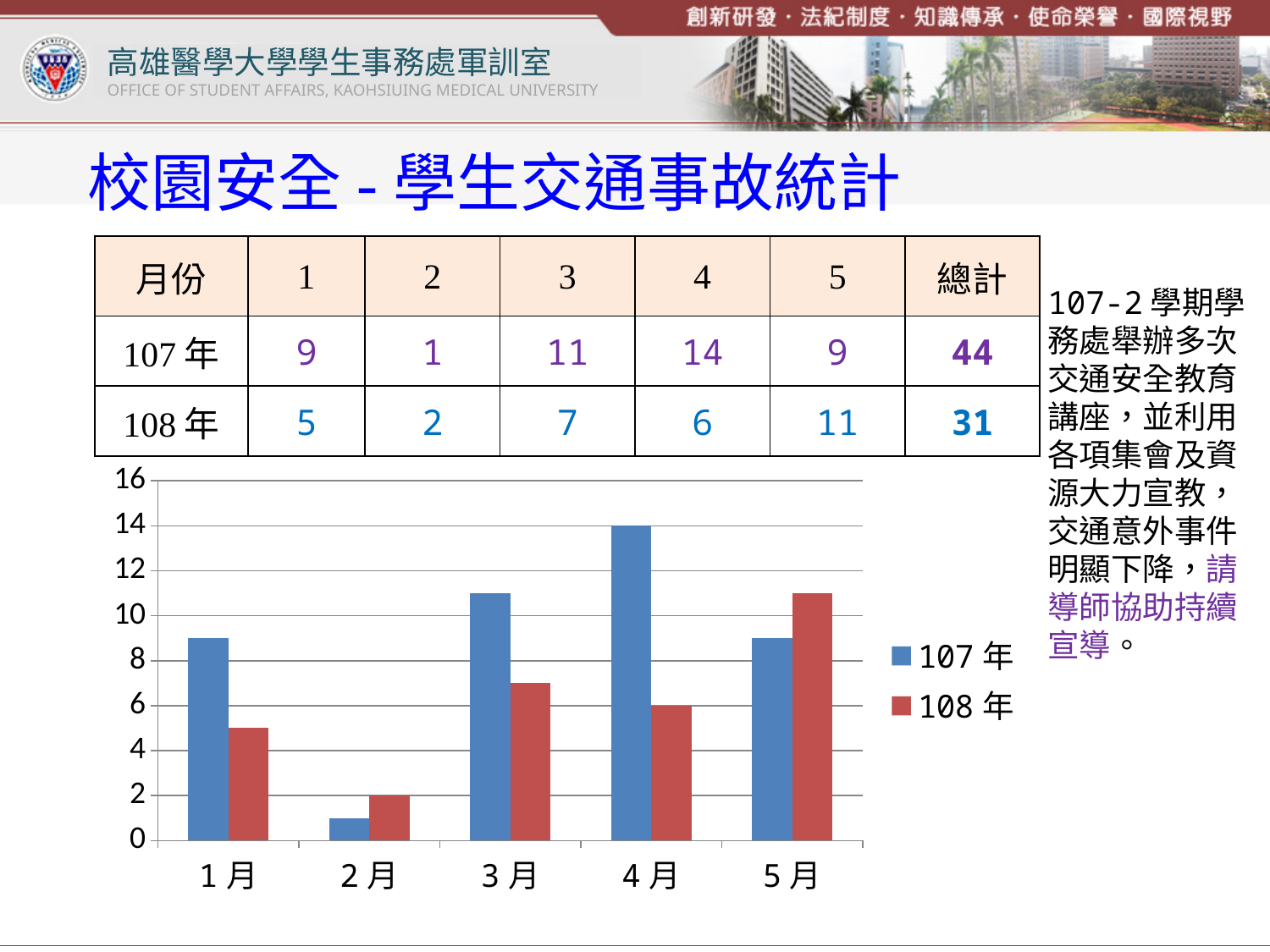
Is the value for 107 年 in 3 月 greater or less than 10? greater How many series does the chart legend list? 2 In 5 月, which series has the larger value, 107 年 or 108 年? 108 年 What kind of chart is shown on the slide? bar chart Which month has the highest value for 107 年? 4 月 What is the difference between the 107 年 and 108 年 values in 4 月? 8 What is the value for 107 年 in 4 月? 14 Which month has the lowest value for 107 年? 2 月 Which month has the lowest value for 108 年? 2 月 What is the value for 108 年 in 5 月? 11 How many month categories are shown on the x axis of the chart? 5 What colour are the bars for 108 年 in the chart? red